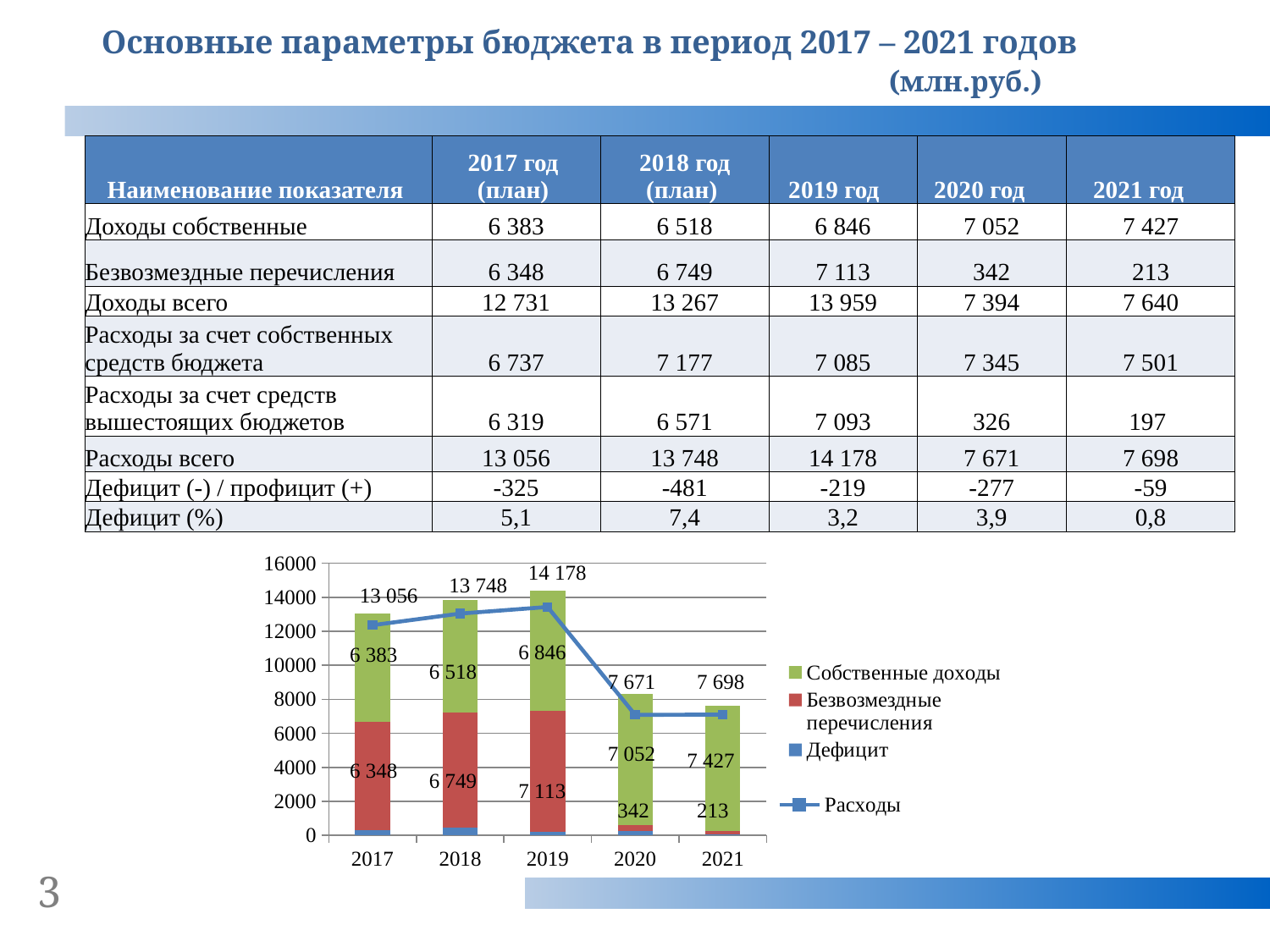
In the chart, which series is shown in green? Собственные доходы In the chart, what is the difference between Собственные доходы in 2021 and in 2017? 1 044 In the chart, does the Расходы line rise or fall from 2019 to 2020? Fall In the chart, what is the value of the Расходы line for 2020? 7 671 How many series does the chart legend list? 4 In the chart, which year has the highest value of the Расходы line? 2019 In the chart, which year has the lowest value of Безвозмездные перечисления? 2021 In the chart, what is the value of Собственные доходы for 2019? 6 846 What kind of chart is shown at the bottom of the slide? A stacked bar chart with a line In the chart, what is the value of Безвозмездные перечисления for 2018? 6 749 How many years are shown on the x axis of the chart? 5 In the chart, which is larger: Безвозмездные перечисления in 2019 or Собственные доходы in 2019? Безвозмездные перечисления in 2019